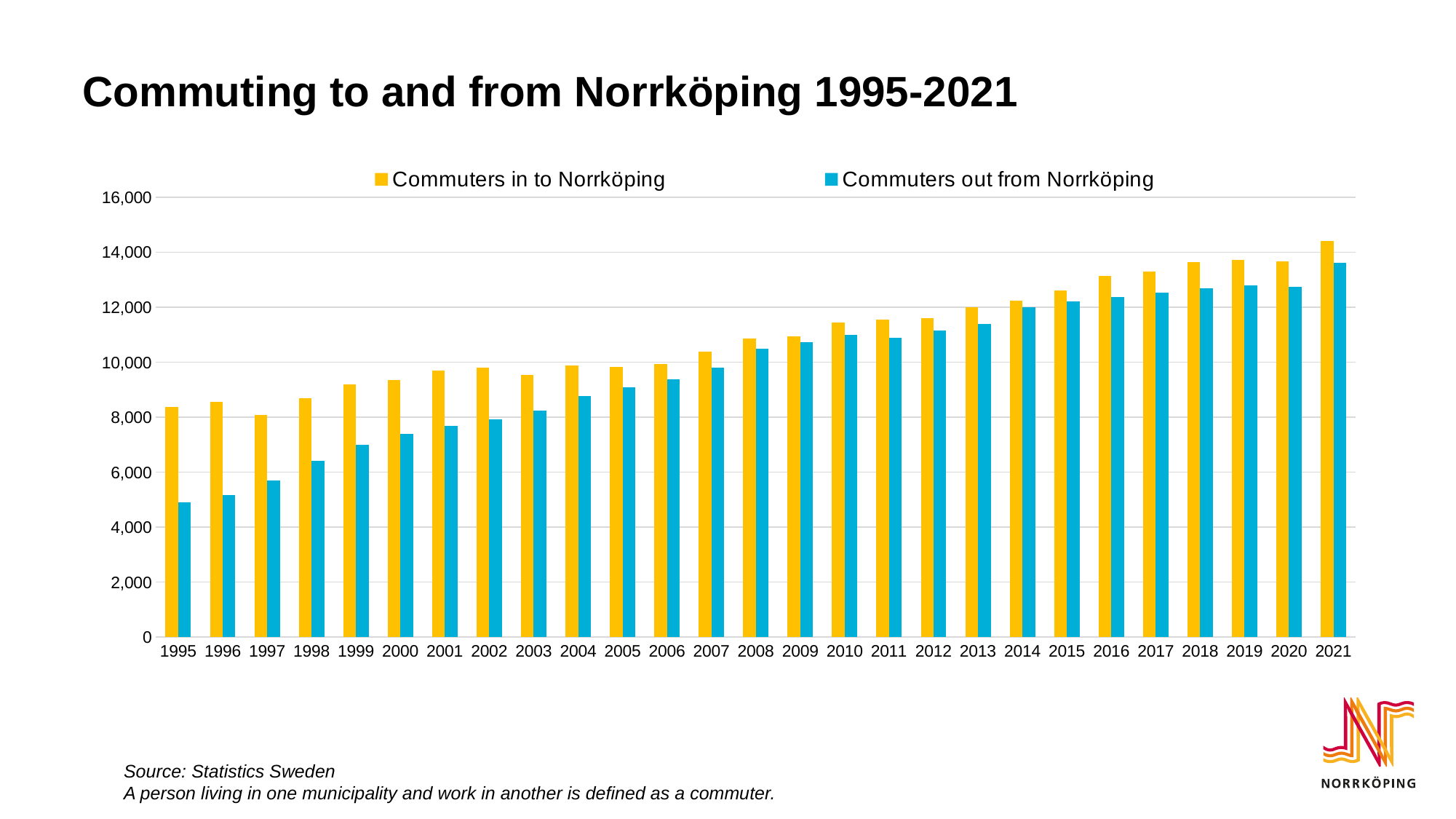
Do the values for Commuters out from Norrköping generally rise or fall from 1995 to 2021? Rise Is the value for Commuters out from Norrköping in 2000 greater or less than 8,000? less In which year is the value for Commuters in to Norrköping the highest? 2021 Is the value for Commuters in to Norrköping in 2016 greater or less than 12,000? greater Is the value for Commuters out from Norrköping in 1995 greater or less than 6,000? less How many series does the legend list? 2 What colour represents Commuters in to Norrköping in the legend? Yellow In which year is the value for Commuters out from Norrköping the lowest? 1995 In 1995, which is larger: Commuters in to Norrköping or Commuters out from Norrköping? Commuters in to Norrköping What kind of chart is shown on the slide? Bar chart How many years are shown on the x axis? 27